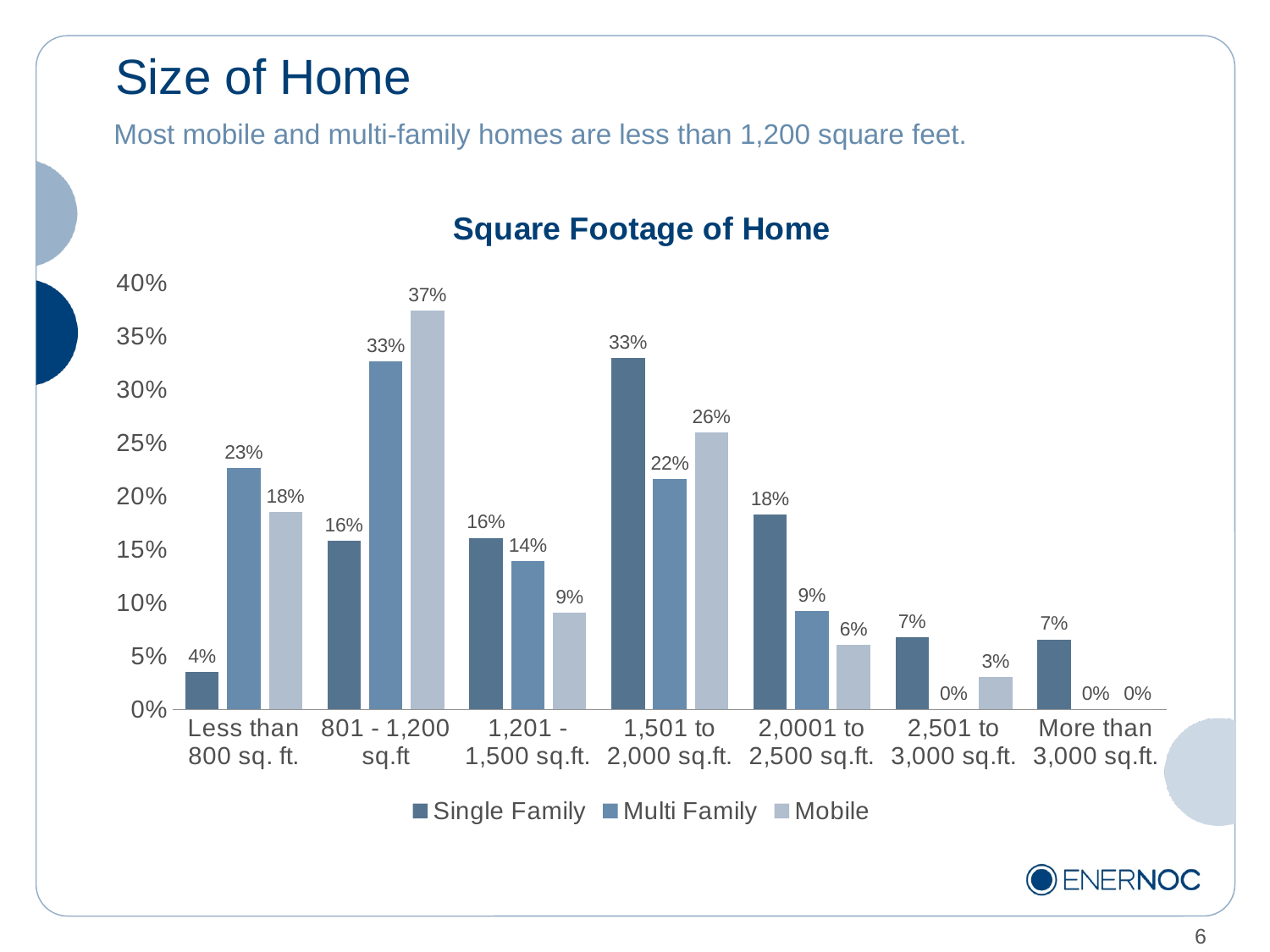
What is the title of the chart? Square Footage of Home What is the Multi Family value for the Less than 800 sq. ft. category? 23% What is the difference between the Mobile and Single Family values for the 801 - 1,200 sq.ft category? 21% What kind of chart is shown on the slide? Bar chart How many square footage categories are shown on the x axis? 7 How many series does the legend list? 3 What is the Mobile value for the 801 - 1,200 sq.ft category? 37% Which category has the lowest Single Family value? Less than 800 sq. ft. Which is larger for the 1,201 - 1,500 sq.ft. category, Single Family or Mobile? Single Family What is the Multi Family value for the More than 3,000 sq.ft. category? 0% Which category has the highest Single Family value? 1,501 to 2,000 sq.ft. What is the Single Family value for the 1,501 to 2,000 sq.ft. category? 33%